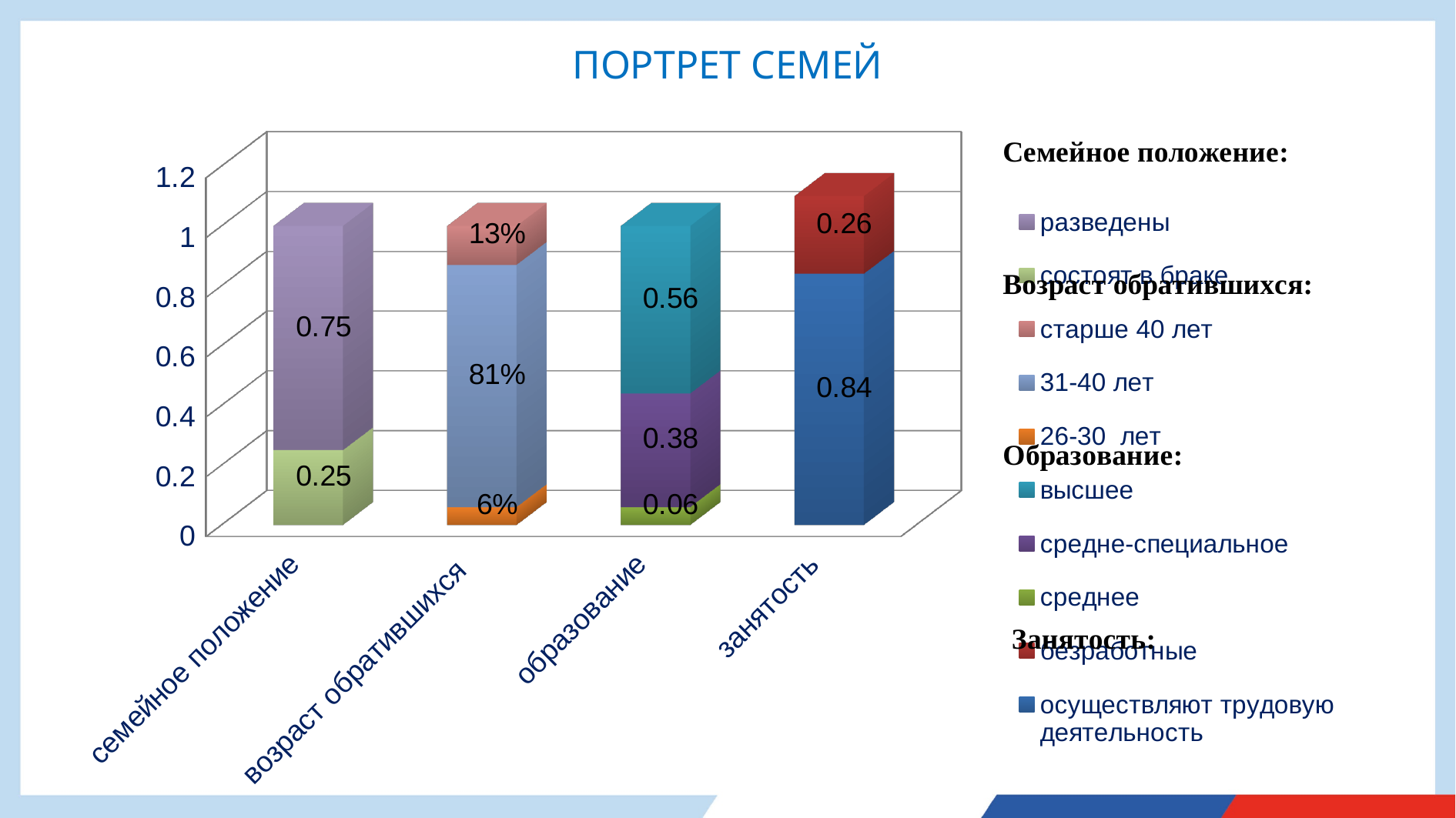
What is the value labelled for 'старше 40 лет' in the 'возраст обратившихся' bar? 13% What is the difference between the 'разведены' and 'состоят в браке' values in the 'семейное положение' bar? 0.5 What is the value labelled for 'состоят в браке' in the 'семейное положение' bar? 0.25 What is the total of the labelled segments in the 'образование' bar? 1.00 What is the value labelled for 'осуществляют трудовую деятельность' in the 'занятость' bar? 0.84 What is the value labelled for 'высшее' in the 'образование' bar? 0.56 What kind of chart is shown on the slide? stacked bar chart How many categories are shown on the x axis of the chart? 4 What is the value labelled for '31-40 лет' in the 'возраст обратившихся' bar? 81% What is the title of the chart on the slide? ПОРТРЕТ СЕМЕЙ What is the value labelled for 'разведены' in the 'семейное положение' bar? 0.75 Which is larger in the 'занятость' bar: 'безработные' or 'осуществляют трудовую деятельность'? осуществляют трудовую деятельность